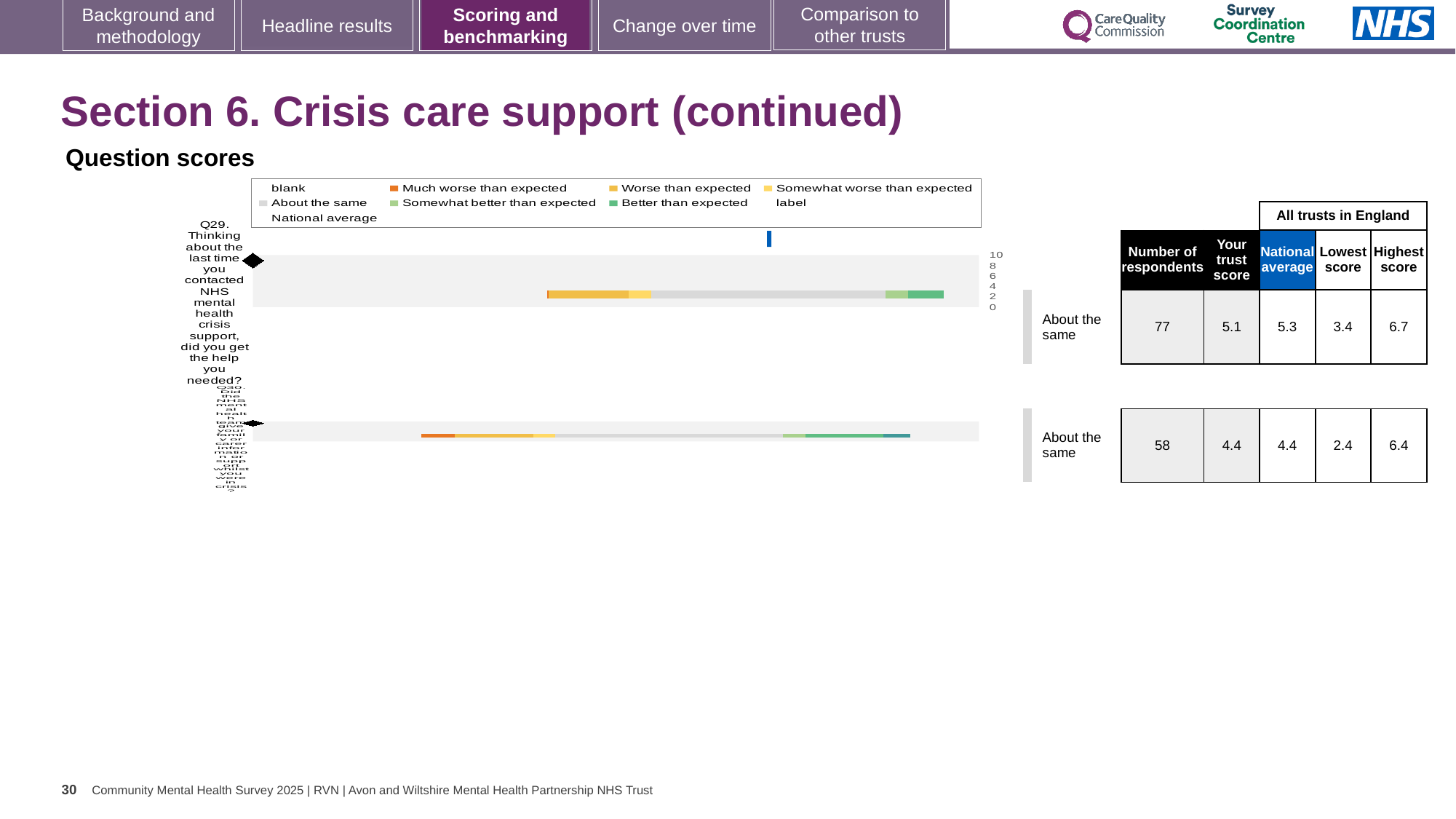
How many questions (categories) are plotted in the chart? 2 For Q29, which is larger: your trust score or the national average? national average What kind of chart is shown under 'Question scores'? bar chart How many entries does the chart legend list? 9 For Q29, what is the difference between the highest score (6.7) and the lowest score (3.4)? 3.3 What is the national average for Q30 in the table beside the chart? 4.4 Which question had more respondents, Q29 or Q30? Q29 What is the highest tick value shown on the chart's score axis? 10 How many respondents answered Q29? 77 What colour does the legend use for 'Much worse than expected'? orange What is the lowest score across all trusts in England for Q30? 2.4 What is 'Your trust score' for Q29 in the table beside the chart? 5.1